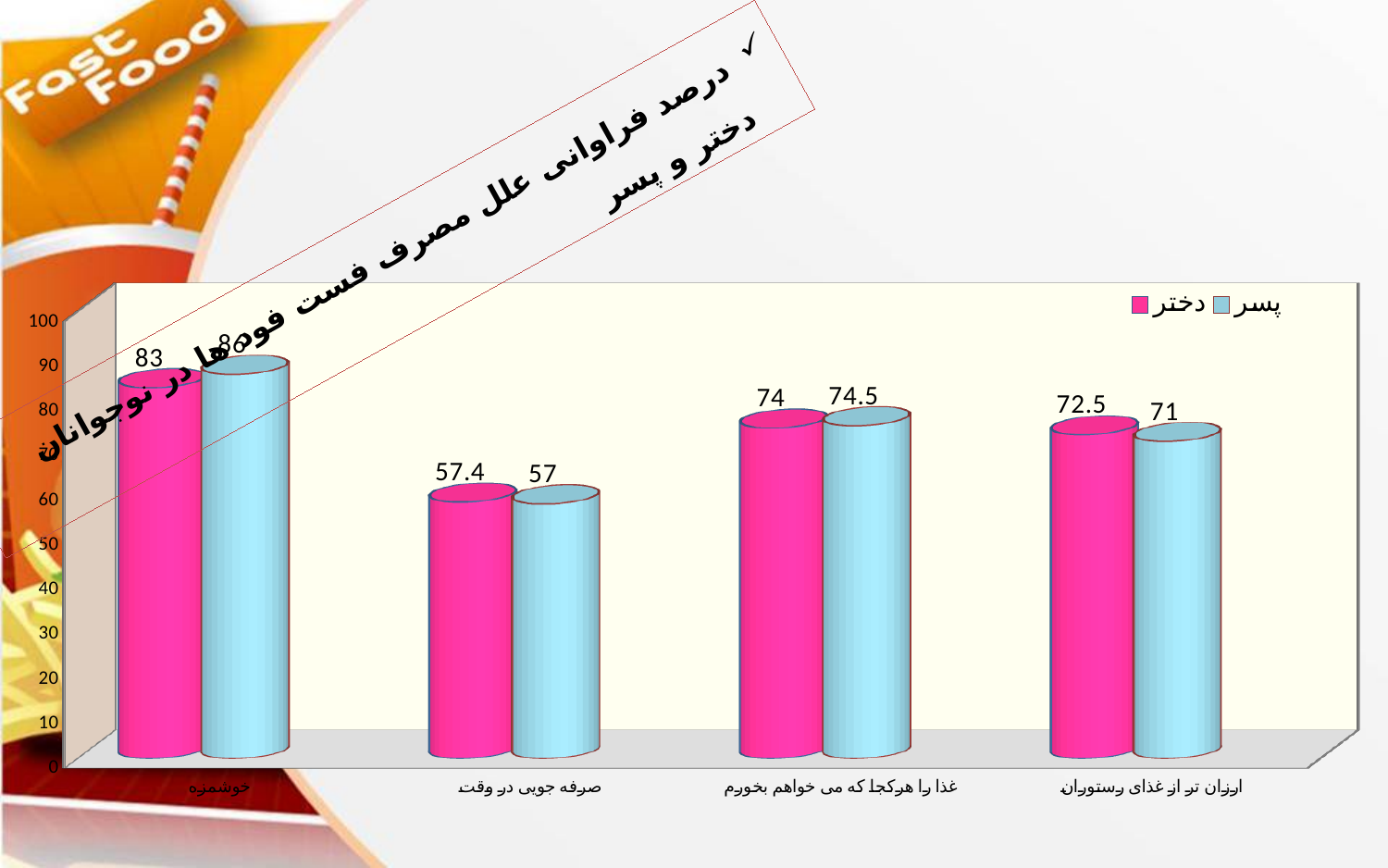
Which category has the lowest value for the پسر series? صرفه جویی در وقت What is the value for پسر in the ارزان تر از غذای رستوران category? 71 Which category has the highest value for the دختر series? خوشمزه What is the value for دختر in the غذا را هرکجا که می خواهم بخورم category? 74 How many series does the legend list? 2 What kind of chart is shown on the slide? bar chart How many categories are shown on the x axis? 4 What is the difference between the دختر and پسر values in the ارزان تر از غذای رستوران category? 1.5 In the غذا را هرکجا که می خواهم بخورم category, which series has the larger value, دختر or پسر? پسر Is the value for پسر in the خوشمزه category greater or less than 80? greater What is the value for پسر in the صرفه جویی در وقت category? 57 What is the value for دختر in the خوشمزه category? 83